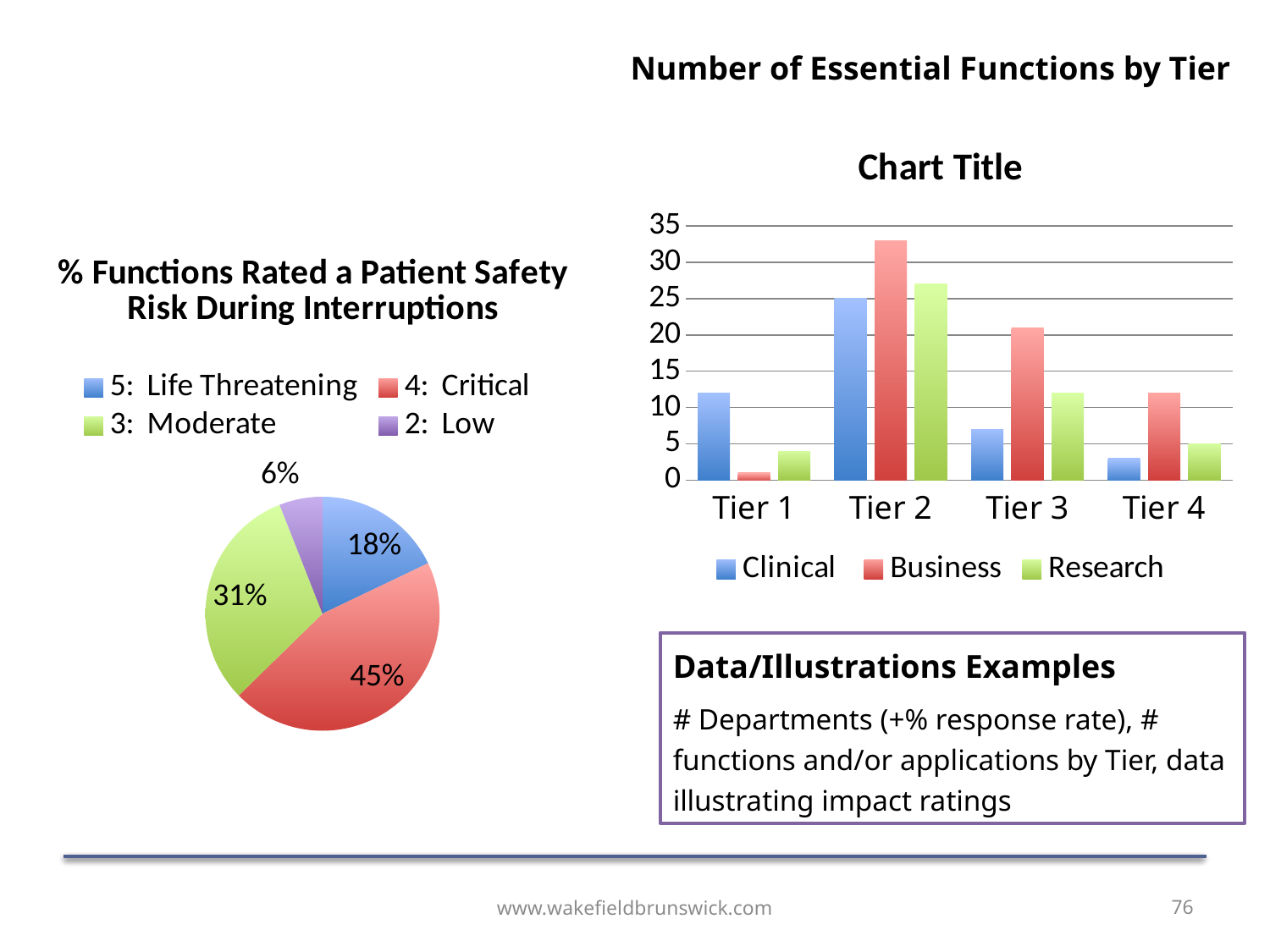
In the pie chart '% Functions Rated a Patient Safety Risk During Interruptions', which category has the smallest slice? 2: Low In the pie chart '% Functions Rated a Patient Safety Risk During Interruptions', what share is labelled for '2: Low'? 6% In the bar chart titled 'Chart Title', is the value for Business in Tier 2 greater or less than 30? greater How many slices does the pie chart '% Functions Rated a Patient Safety Risk During Interruptions' have? 4 In the pie chart '% Functions Rated a Patient Safety Risk During Interruptions', which category has the largest slice? 4: Critical In the pie chart '% Functions Rated a Patient Safety Risk During Interruptions', what share is labelled for '3: Moderate'? 31% In the bar chart titled 'Chart Title', which tier has the tallest Clinical bar? Tier 2 In the bar chart titled 'Chart Title' on the right, how many series does the legend list? 3 In the pie chart '% Functions Rated a Patient Safety Risk During Interruptions', what is the difference in percentage points between '4: Critical' and '5: Life Threatening'? 27 What kind of chart is the chart titled 'Chart Title' on the right? bar chart In the pie chart '% Functions Rated a Patient Safety Risk During Interruptions', what share is labelled for '4: Critical'? 45% In the bar chart titled 'Chart Title', which is larger in Tier 3: Business or Research? Business